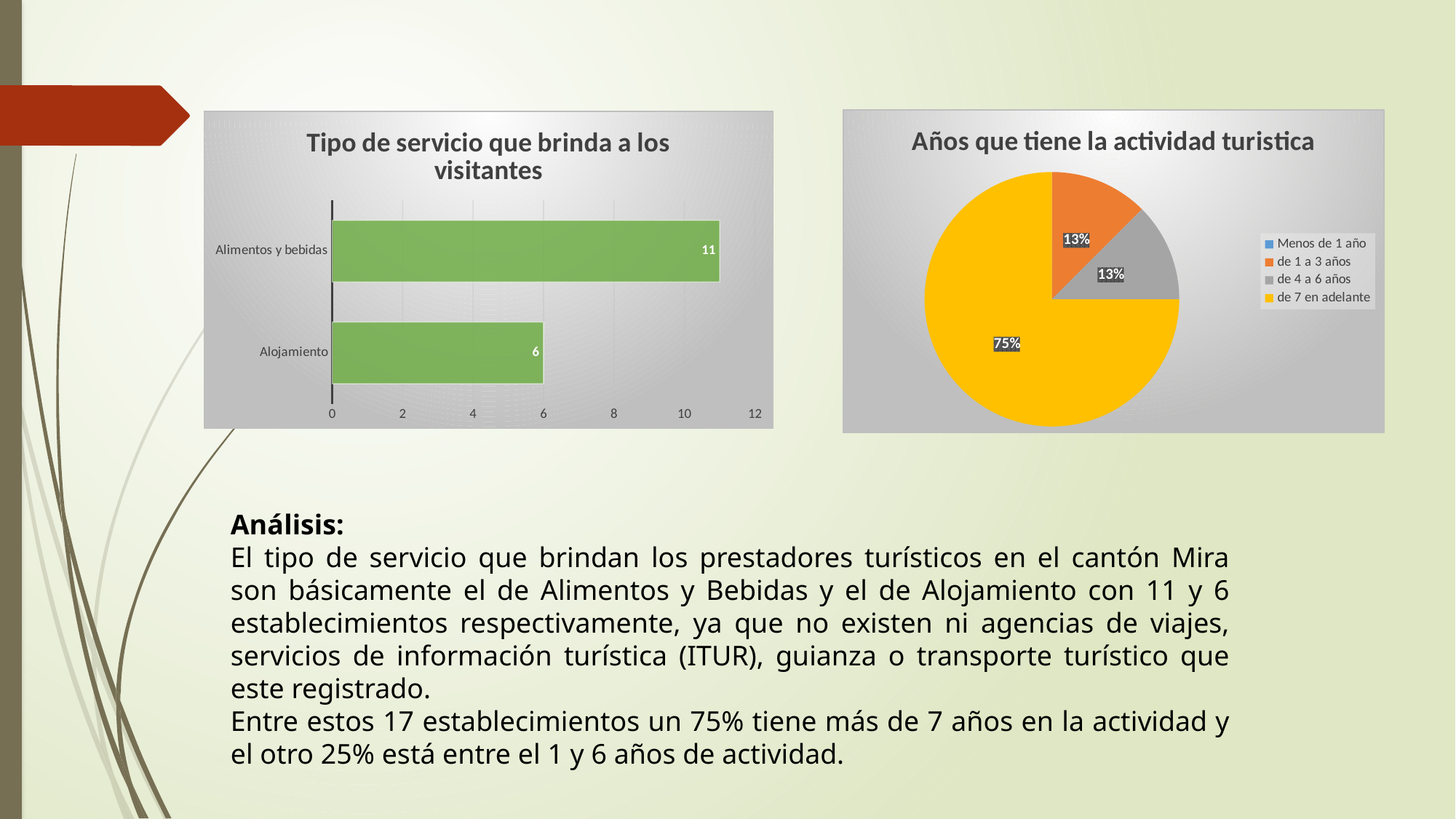
In the chart 'Tipo de servicio que brinda a los visitantes', what is the difference between Alimentos y bebidas and Alojamiento? 5 In the chart 'Tipo de servicio que brinda a los visitantes', what is the value for Alimentos y bebidas? 11 In the chart 'Años que tiene la actividad turistica', which category has the largest slice? de 7 en adelante In the chart 'Tipo de servicio que brinda a los visitantes', what is the value for Alojamiento? 6 What kind of chart is 'Tipo de servicio que brinda a los visitantes'? Bar chart In the chart 'Años que tiene la actividad turistica', what share does 'de 7 en adelante' have? 75% In the chart 'Años que tiene la actividad turistica', what colour is the slice for 'de 7 en adelante'? Yellow What kind of chart is 'Años que tiene la actividad turistica'? Pie chart In the chart 'Tipo de servicio que brinda a los visitantes', how many categories are shown? 2 In the chart 'Años que tiene la actividad turistica', what share does 'de 1 a 3 años' have? 13% In the chart 'Tipo de servicio que brinda a los visitantes', which category has the highest value? Alimentos y bebidas In the chart 'Años que tiene la actividad turistica', how many entries does the legend list? 4